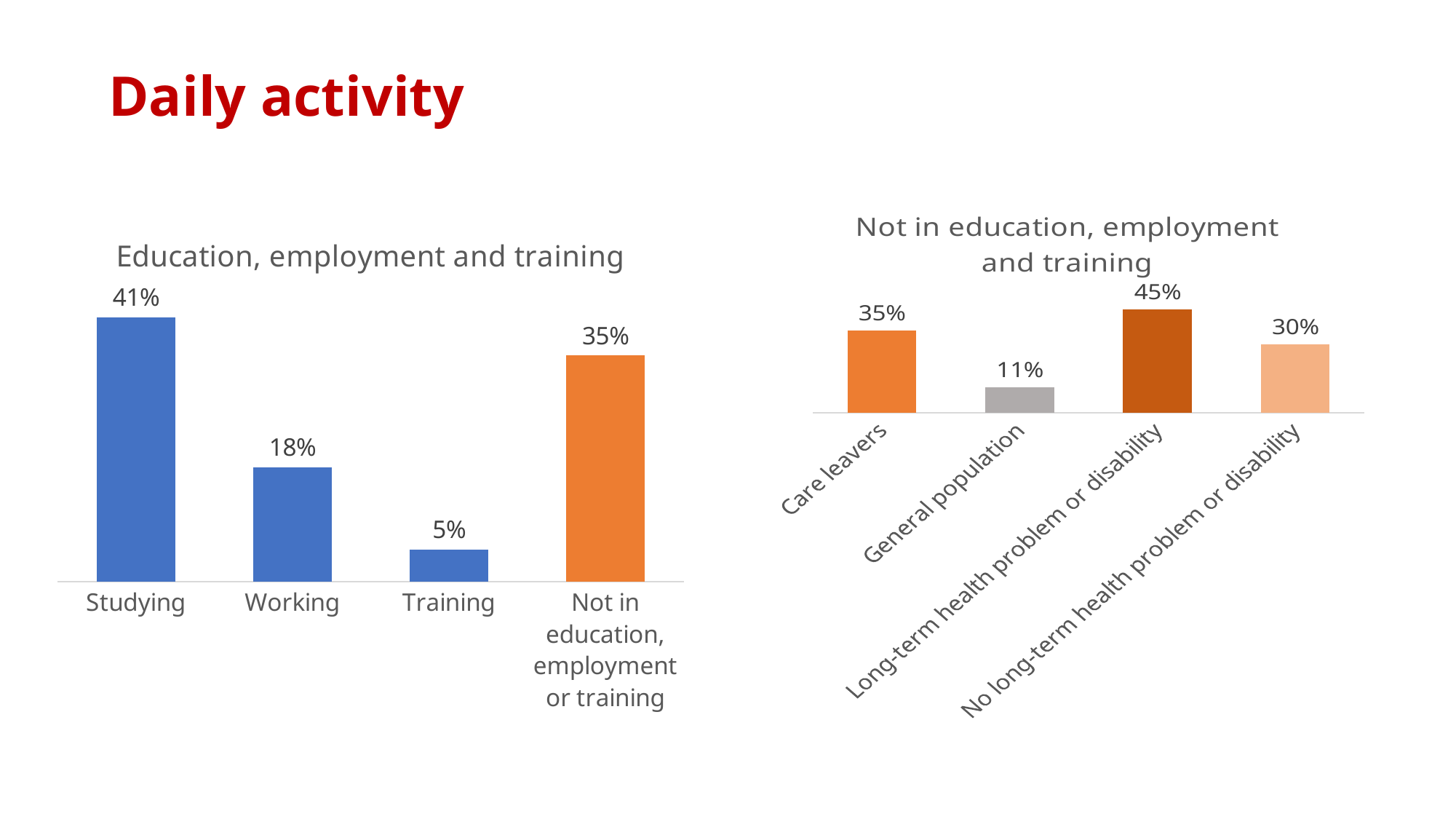
In the 'Not in education, employment and training' chart, which category has the lowest value? General population In the 'Education, employment and training' chart, which category has the lowest value? Training In the 'Education, employment and training' chart, what is the value for Training? 5% In the 'Not in education, employment and training' chart, what is the value for Long-term health problem or disability? 45% In the 'Not in education, employment and training' chart, what is the value for General population? 11% In the 'Not in education, employment and training' chart, what is the difference between Care leavers and General population? 24% In the 'Education, employment and training' chart, what is the value for Studying? 41% What type of chart is the 'Not in education, employment and training' chart? Bar chart In the 'Not in education, employment and training' chart, which is larger: Care leavers or No long-term health problem or disability? Care leavers In the 'Education, employment and training' chart, which category has the highest value? Studying In the 'Education, employment and training' chart, what is the difference between the values for Studying and Working? 23% In the 'Education, employment and training' chart, how many categories are shown? 4